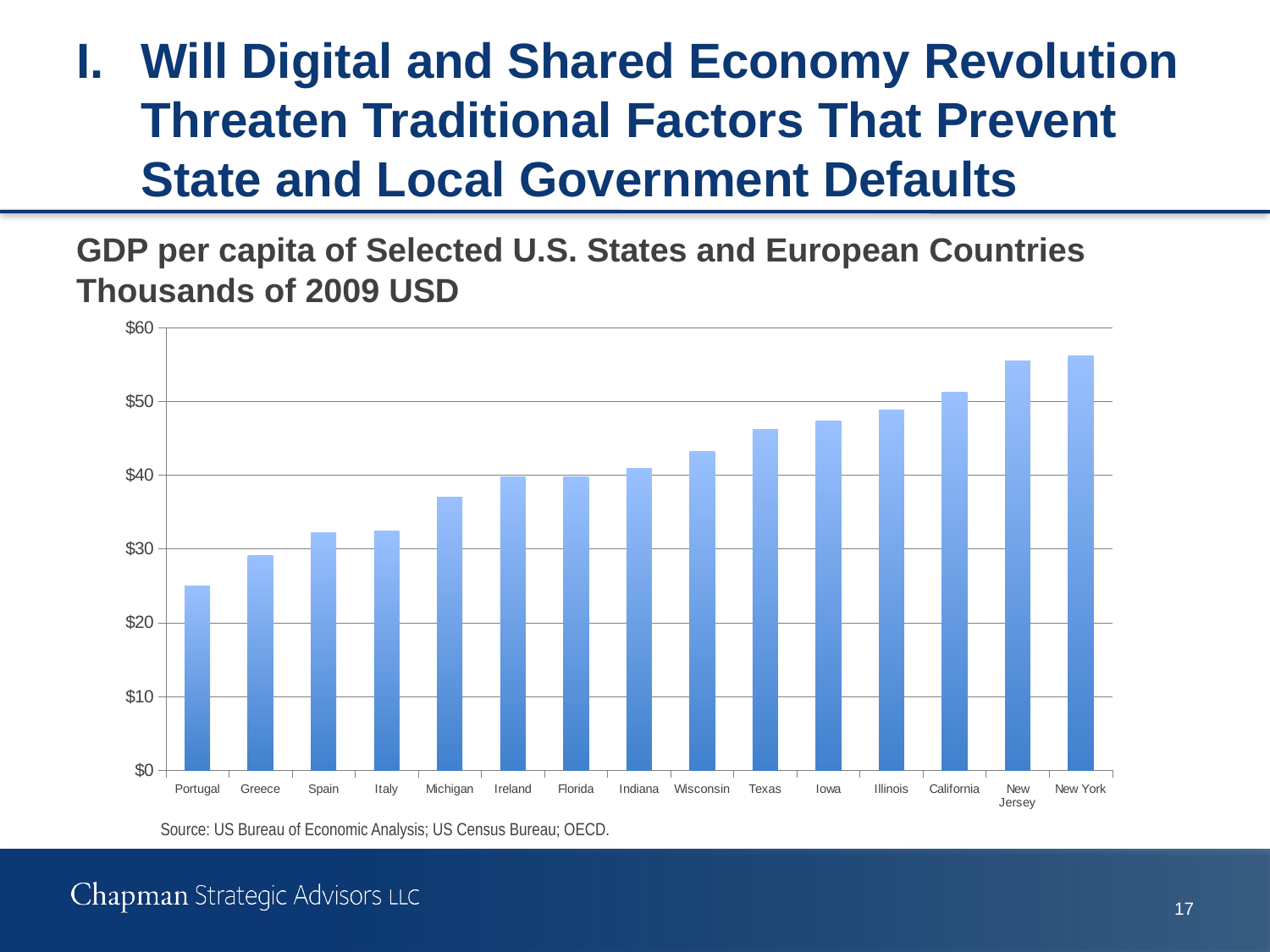
In what units are the values on the chart expressed? Thousands of 2009 USD What kind of chart is shown on the slide? bar chart How many states and countries are plotted on the chart? 15 Which state or country has the lowest GDP per capita on the chart? Portugal Is the value for New Jersey greater or less than $50? greater Is the value for New York greater or less than $60? less Is the value for Michigan greater or less than $40? less Do the values rise or fall moving from left to right across the chart? rise Which has the larger GDP per capita, Texas or Michigan? Texas